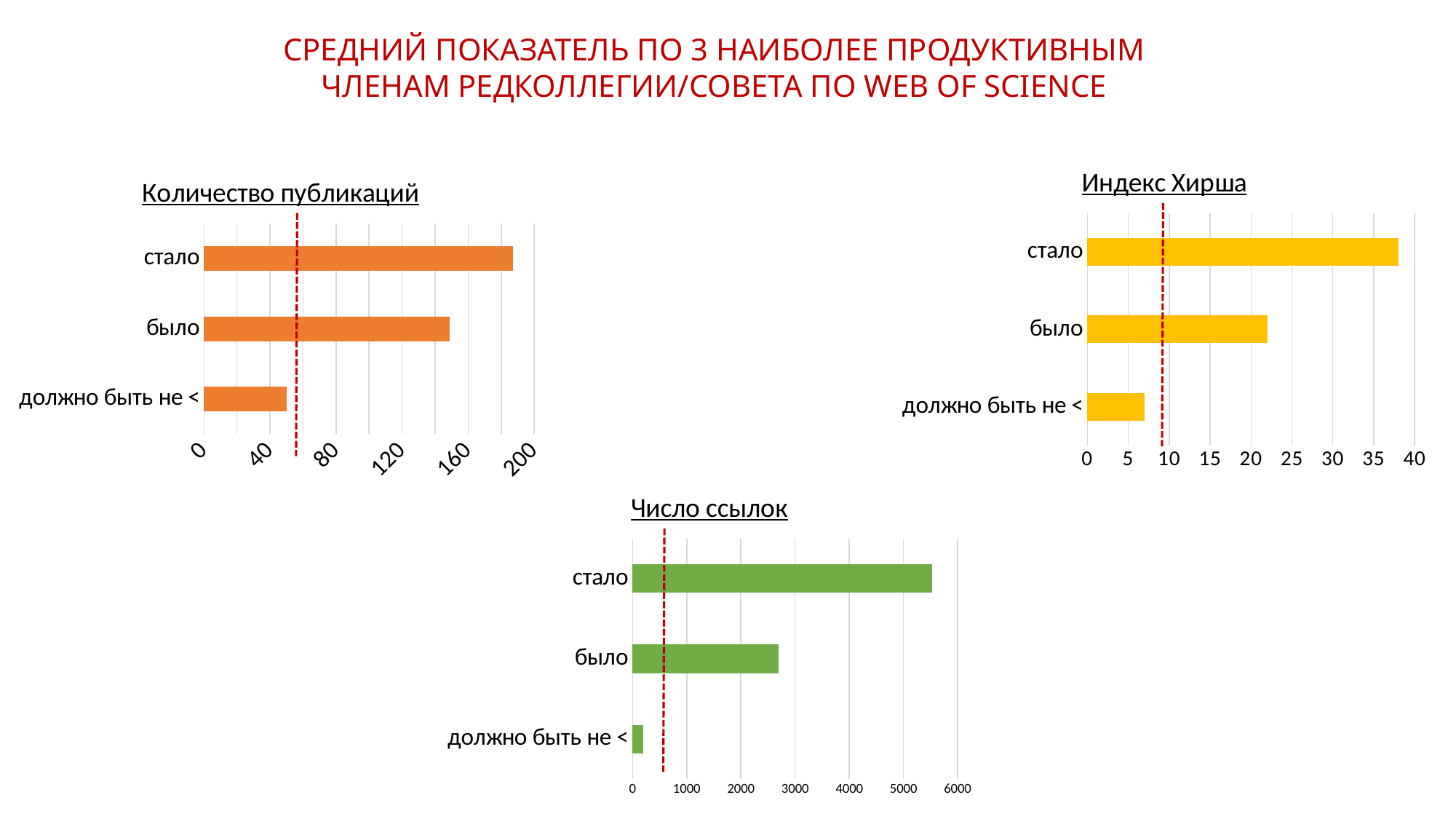
In the chart titled "Количество публикаций", how many categories are plotted? 3 In the chart titled "Индекс Хирша", which is larger, the value for "было" or the value for "должно быть не <"? было In the chart titled "Число ссылок", is the value for "было" greater or less than 2000? greater In the chart titled "Число ссылок", is the value for "стало" greater or less than 5000? greater In the chart titled "Количество публикаций", which category has the lowest value? должно быть не < What colour are the bars in the chart titled "Число ссылок"? green In the chart titled "Количество публикаций", what kind of chart is shown? bar chart In the chart titled "Индекс Хирша", which category has the highest value? стало In the chart titled "Индекс Хирша", is the value for "должно быть не <" greater or less than 10? less In the chart titled "Число ссылок", which category has the lowest value? должно быть не < In the chart titled "Количество публикаций", which category has the highest value? стало